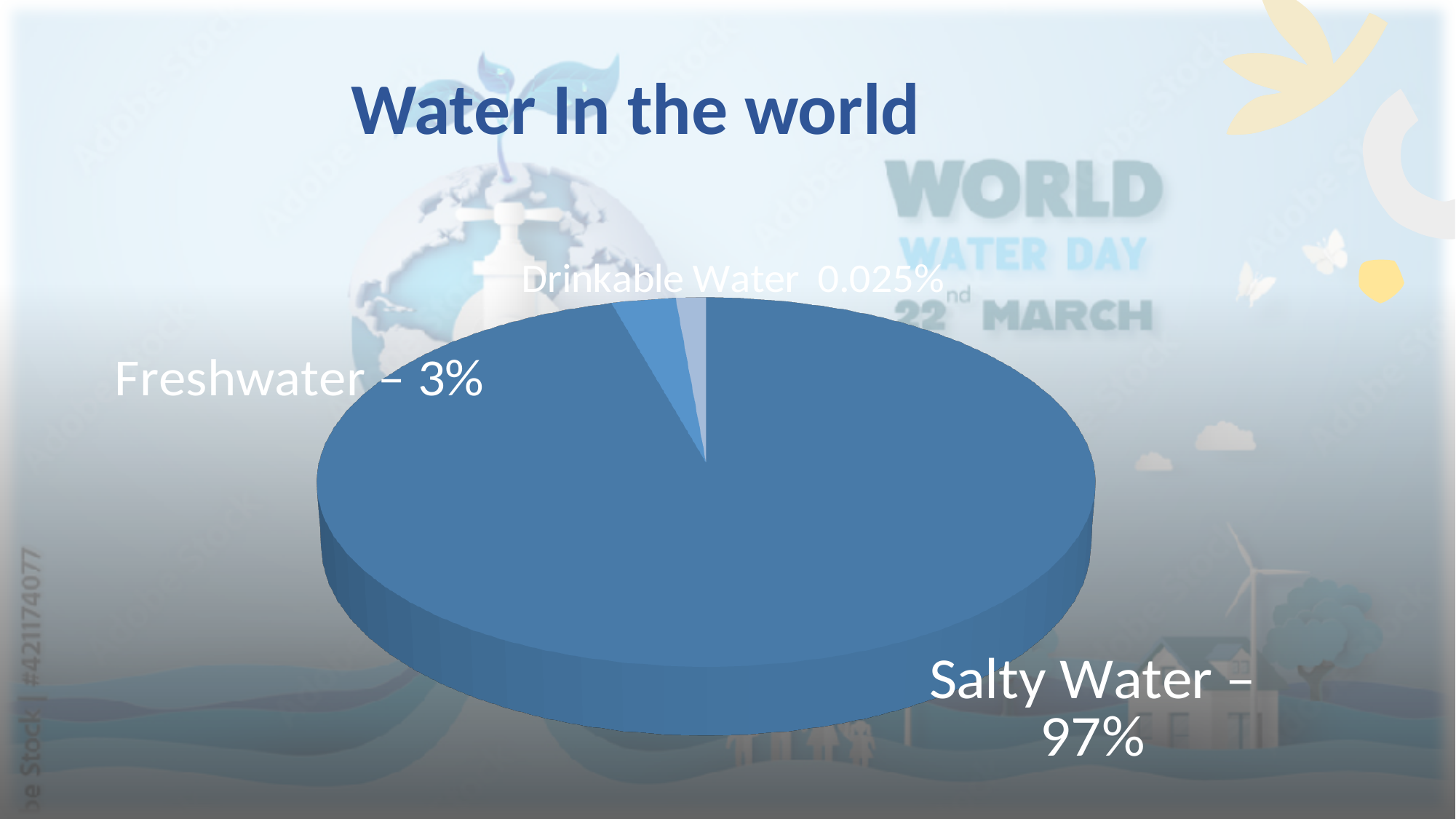
What percentage is shown for Freshwater? 3% Which slice is labelled with the value 3%? Freshwater What is the title of the chart on the slide? Water In the world What percentage is shown for Salty Water? 97% Which slice of the pie is the smallest? Drinkable Water What is the difference between the Salty Water and Freshwater percentages? 94% Which is larger, Freshwater or Drinkable Water? Freshwater What share of the pie does Salty Water represent? 97% What percentage is shown for Drinkable Water? 0.025% Which slice of the pie is the largest? Salty Water How many slices does the pie chart have? 3 What kind of chart is shown on the slide? pie chart